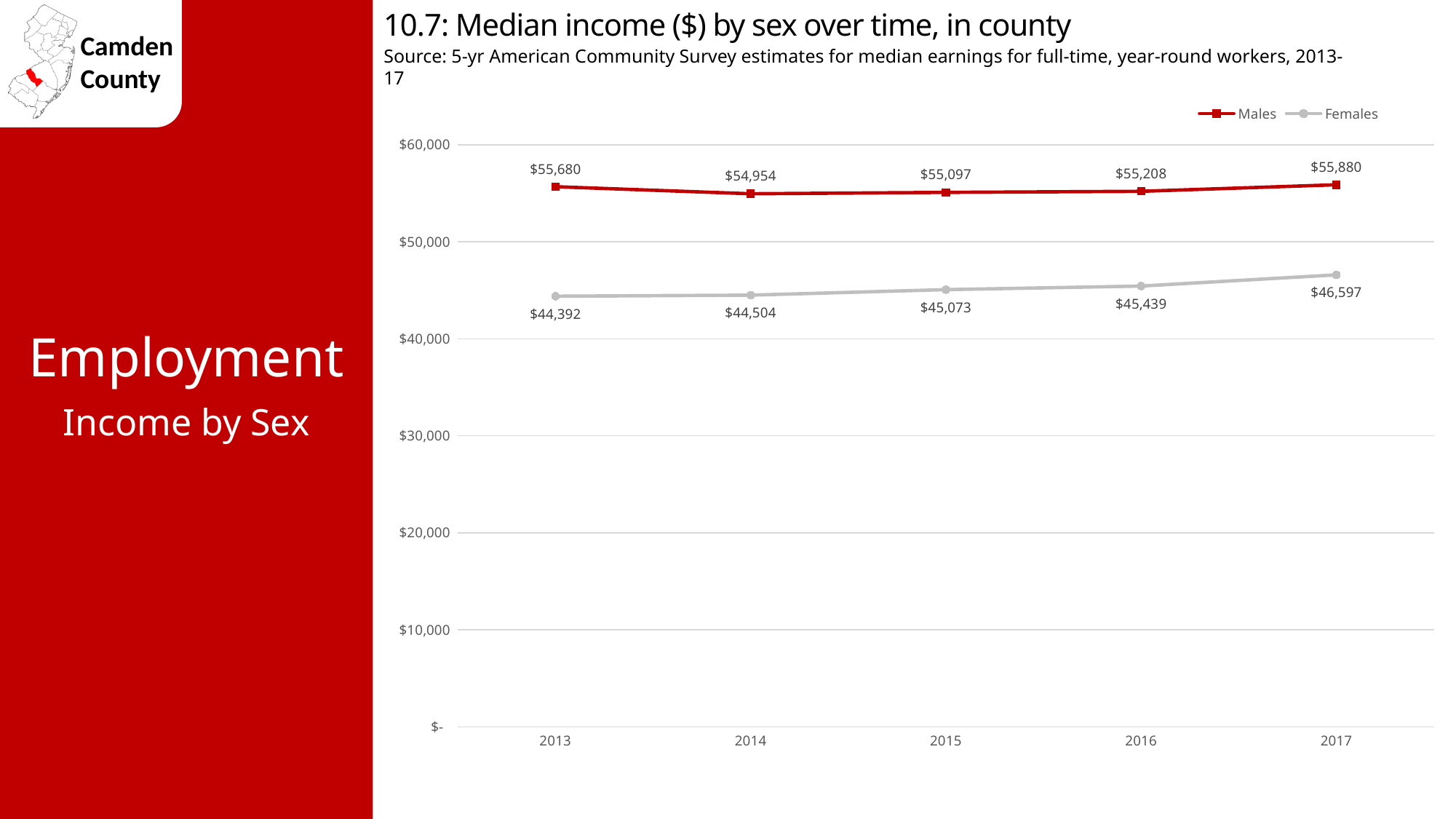
Does the Females median income rise or fall from 2013 to 2017? Rise Which series had the higher median income in 2016, Males or Females? Males What was the median income for Females in 2017? $46,597 What was the median income for Females in 2015? $45,073 How many series does the legend list? 2 What was the median income for Males in 2013? $55,680 What is the difference between the Males and Females median income in 2017? $9,283 In which year was the Males median income lowest? 2014 In which year was the Females median income highest? 2017 What is the difference between the Females median income in 2017 and in 2013? $2,205 How many years are shown on the x axis? 5 What kind of chart is shown on the slide? Line chart